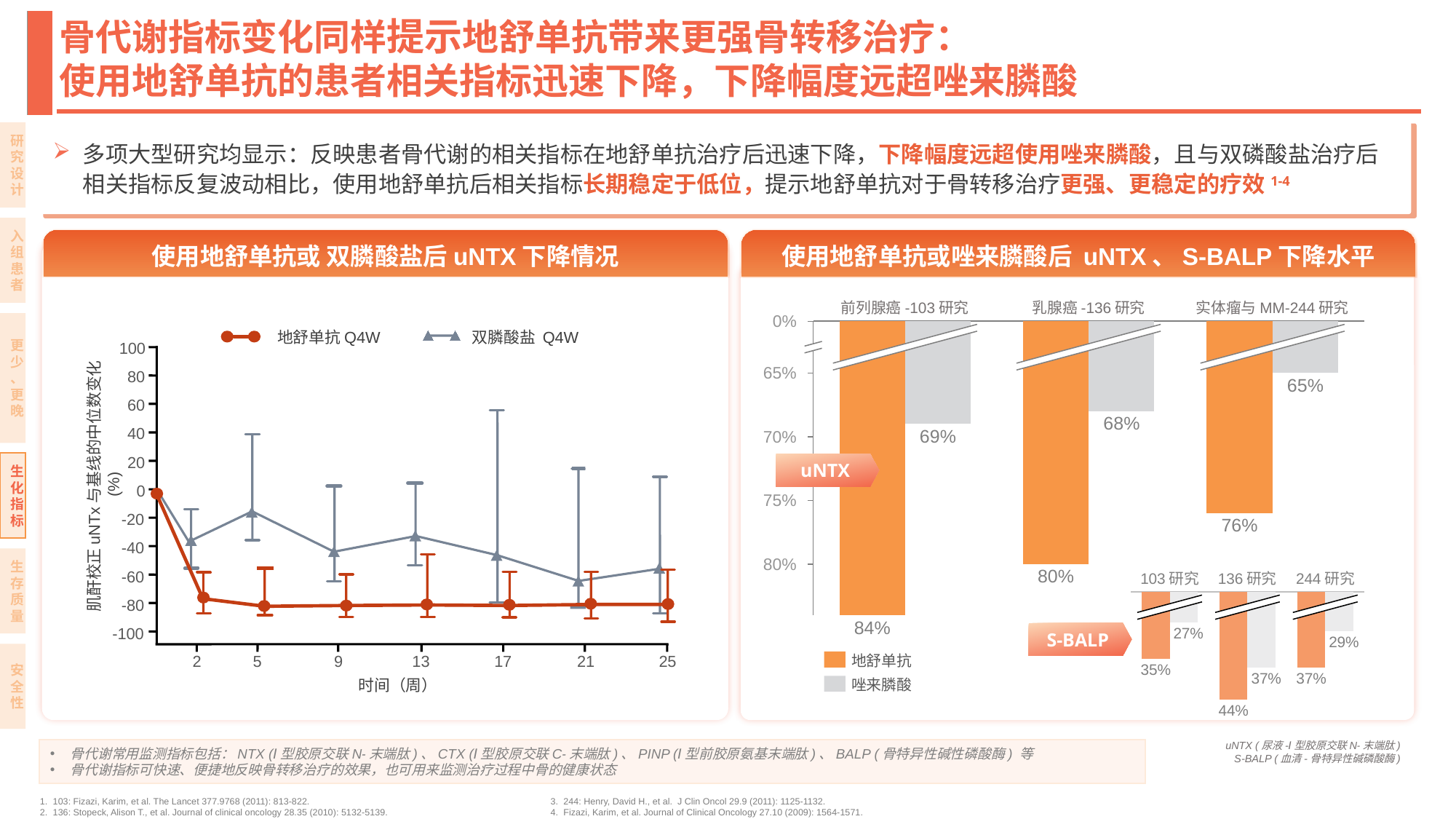
In the right chart (使用地舒单抗或唑来膦酸后 uNTX 、 S-BALP 下降水平), what is the difference between the uNTX values for 地舒单抗 and 唑来膦酸 in the 实体瘤与 MM-244 研究? 11% In the right chart (使用地舒单抗或唑来膦酸后 uNTX 、 S-BALP 下降水平), which colour represents 唑来膦酸 in the legend? grey In the right chart (使用地舒单抗或唑来膦酸后 uNTX 、 S-BALP 下降水平), what is the uNTX value for 地舒单抗 in the 前列腺癌-103 研究? 84% In the left chart (使用地舒单抗或 双膦酸盐后 uNTX 下降情况), what is the label of the x axis? 时间（周） In the left chart (使用地舒单抗或 双膦酸盐后 uNTX 下降情况), which series has the lower value at week 2, 地舒单抗 Q4W or 双膦酸盐 Q4W? 地舒单抗 Q4W In the left chart (使用地舒单抗或 双膦酸盐后 uNTX 下降情况), is the value for 地舒单抗 Q4W at week 25 greater or less than -60? less In the left chart (使用地舒单抗或 双膦酸盐后 uNTX 下降情况), how many series does the legend list? 2 In the right chart (使用地舒单抗或唑来膦酸后 uNTX 、 S-BALP 下降水平), what is the uNTX value for 唑来膦酸 in the 乳腺癌-136 研究? 68% In the left chart (使用地舒单抗或 双膦酸盐后 uNTX 下降情况), what kind of chart is it? line chart In the right chart (使用地舒单抗或唑来膦酸后 uNTX 、 S-BALP 下降水平), which study has the lowest S-BALP value for 唑来膦酸? 103 研究 In the right chart (使用地舒单抗或唑来膦酸后 uNTX 、 S-BALP 下降水平), what is the S-BALP value for 地舒单抗 in the 136 研究? 44% In the right chart (使用地舒单抗或唑来膦酸后 uNTX 、 S-BALP 下降水平), which study has the highest uNTX value for 地舒单抗? 前列腺癌-103 研究